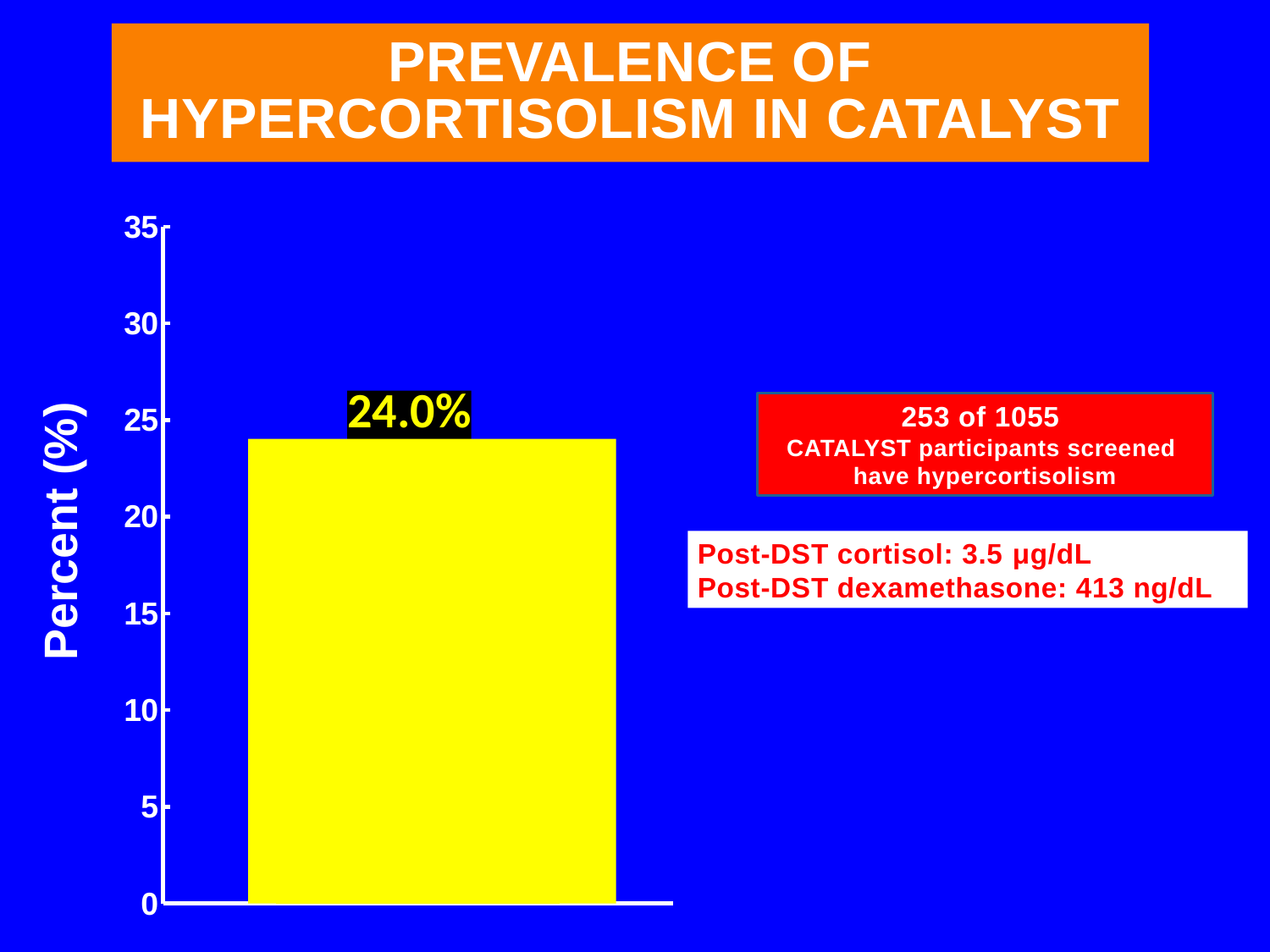
What is the value shown on the bar in the chart? 24.0% What colour is the bar in the chart? yellow Is the value of the bar greater or less than 25? less Is the value of the bar greater or less than 20? greater What kind of chart is shown on the slide? bar chart What is the maximum value shown on the y axis? 35 How many bars are plotted in the chart? 1 What is the label of the y axis? Percent (%)